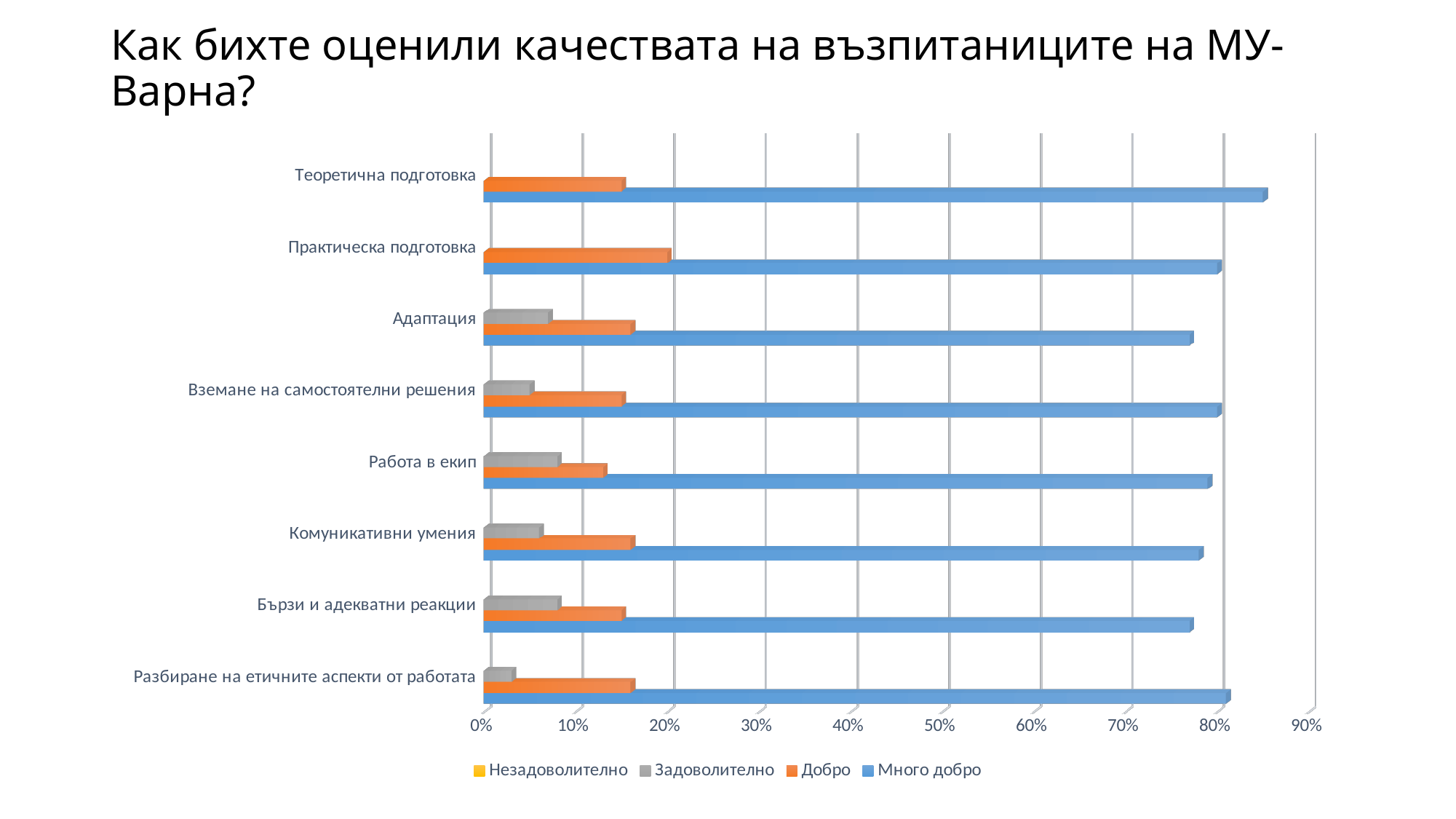
Is the 'Много добро' value for 'Теоретична подготовка' greater or less than 80%? greater Which category has the highest value for the 'Добро' series? Практическа подготовка Which category has the highest value for the 'Много добро' series? Теоретична подготовка Which colour represents the 'Много добро' series in the chart legend? Blue Is the 'Добро' value for 'Практическа подготовка' greater or less than 10%? greater Which is larger: the 'Много добро' value for 'Теоретична подготовка' or for 'Практическа подготовка'? Теоретична подготовка What kind of chart is shown on the slide? Bar chart Which is larger: the 'Добро' value for 'Практическа подготовка' or for 'Работа в екип'? Практическа подготовка How many series does the chart legend list? 4 Is the 'Задоволително' value for 'Разбиране на етичните аспекти от работата' greater or less than 10%? less How many categories (qualities) are listed on the vertical axis of the chart? 8